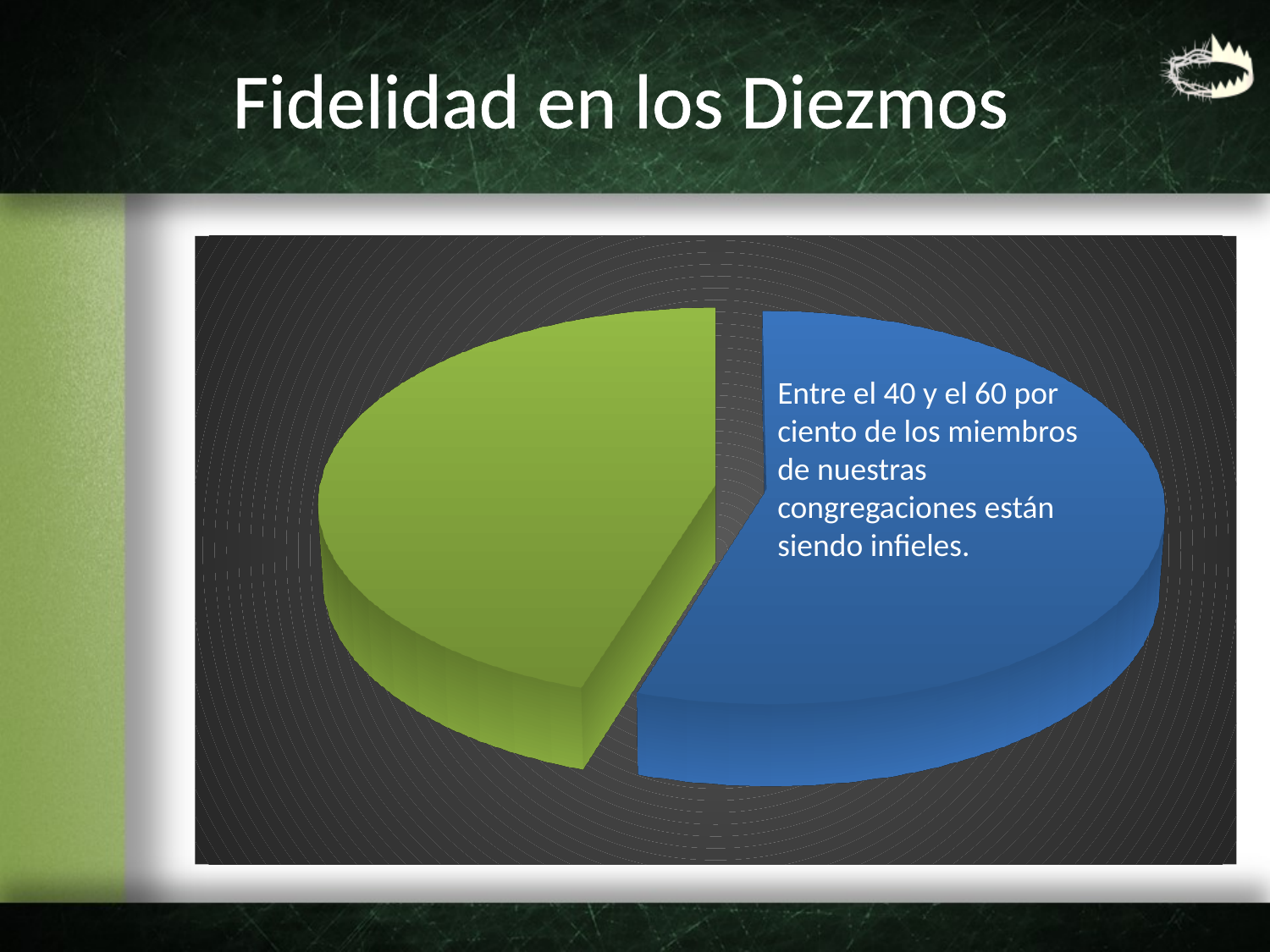
What two colours are used for the slices of the pie chart? green and blue Which slice of the pie chart is larger, the blue one or the green one? blue What is the title of the slide containing the pie chart? Fidelidad en los Diezmos What kind of chart is shown on the slide? pie chart How many slices does the pie chart have? 2